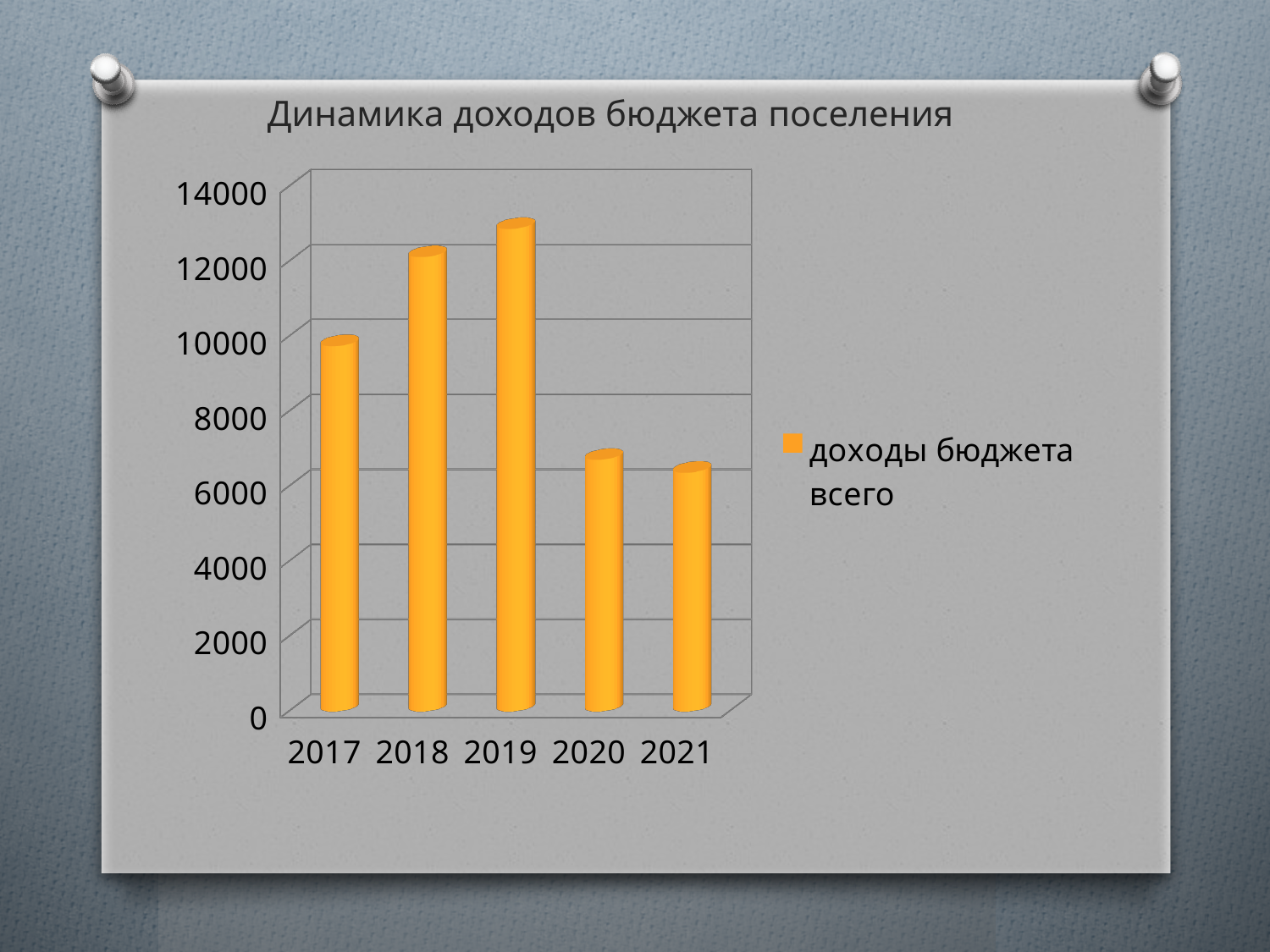
What series name does the legend list? доходы бюджета всего How many series does the legend list? 1 Which is larger, the value for 2017 or the value for 2020? 2017 Is the value for 2017 greater or less than 8000? greater Is the value for 2021 greater or less than 6000? greater Which year has the highest budget income? 2019 What is the title of the chart? Динамика доходов бюджета поселения How many years are shown on the x axis? 5 Do the values rise or fall from 2019 to 2020? fall Is the value for 2020 greater or less than 8000? less What kind of chart is shown on the slide? bar chart